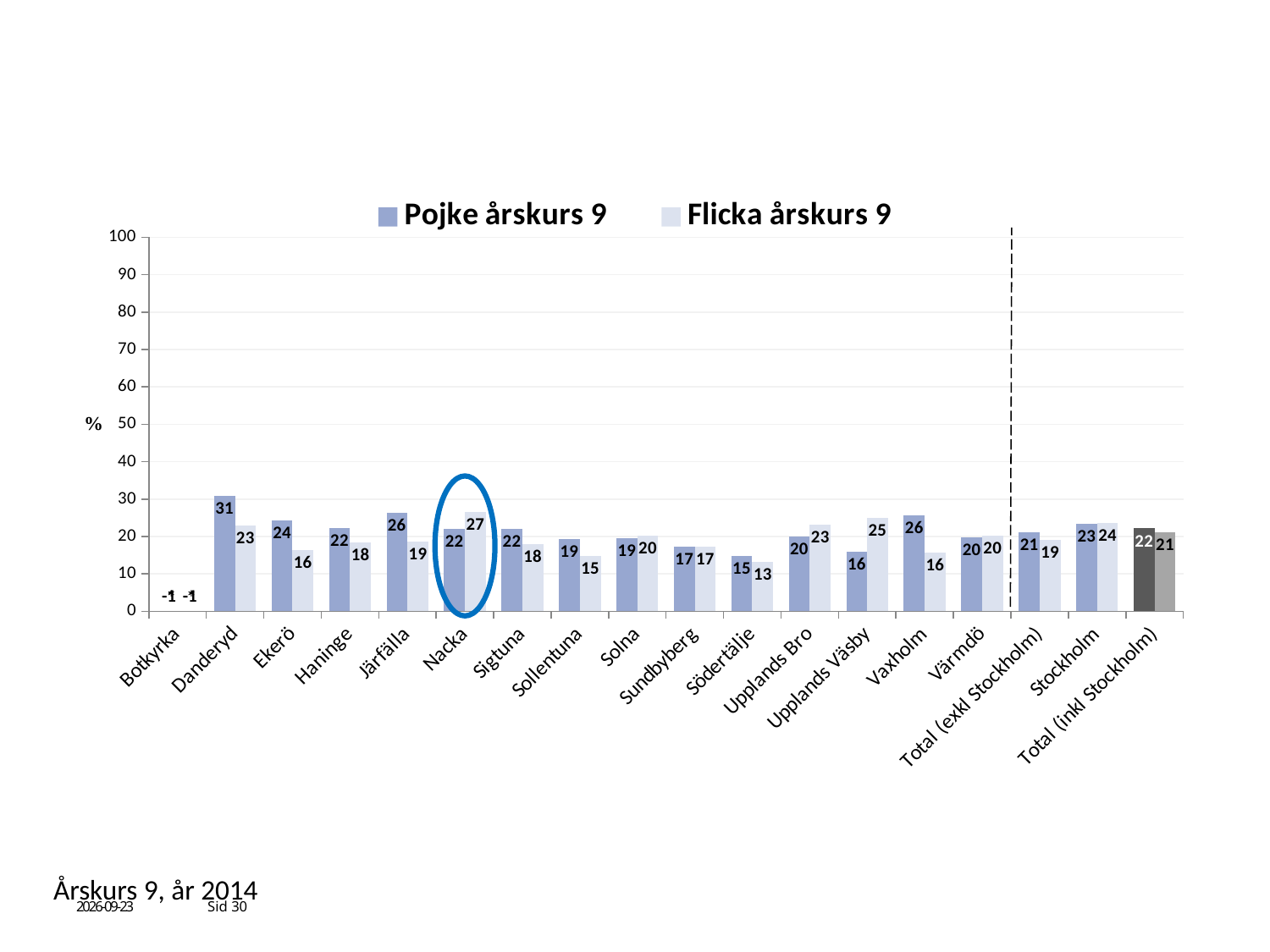
What is the value for Pojke årskurs 9 for Total (inkl Stockholm)? 22 In Ekerö, which is larger: the Pojke årskurs 9 value or the Flicka årskurs 9 value? Pojke årskurs 9 What is the value for Flicka årskurs 9 in Upplands Väsby? 25 Which category is circled on the chart? Nacka How many categories are shown on the x axis? 18 Which category has the highest value for Pojke årskurs 9? Danderyd Which category has the highest value for Flicka årskurs 9? Nacka How many series does the legend list? 2 What is the value for Flicka årskurs 9 in Nacka? 27 What kind of chart is shown on the slide? bar chart What is the value for Pojke årskurs 9 in Danderyd? 31 What is the difference between the Pojke årskurs 9 and Flicka årskurs 9 values in Vaxholm? 10